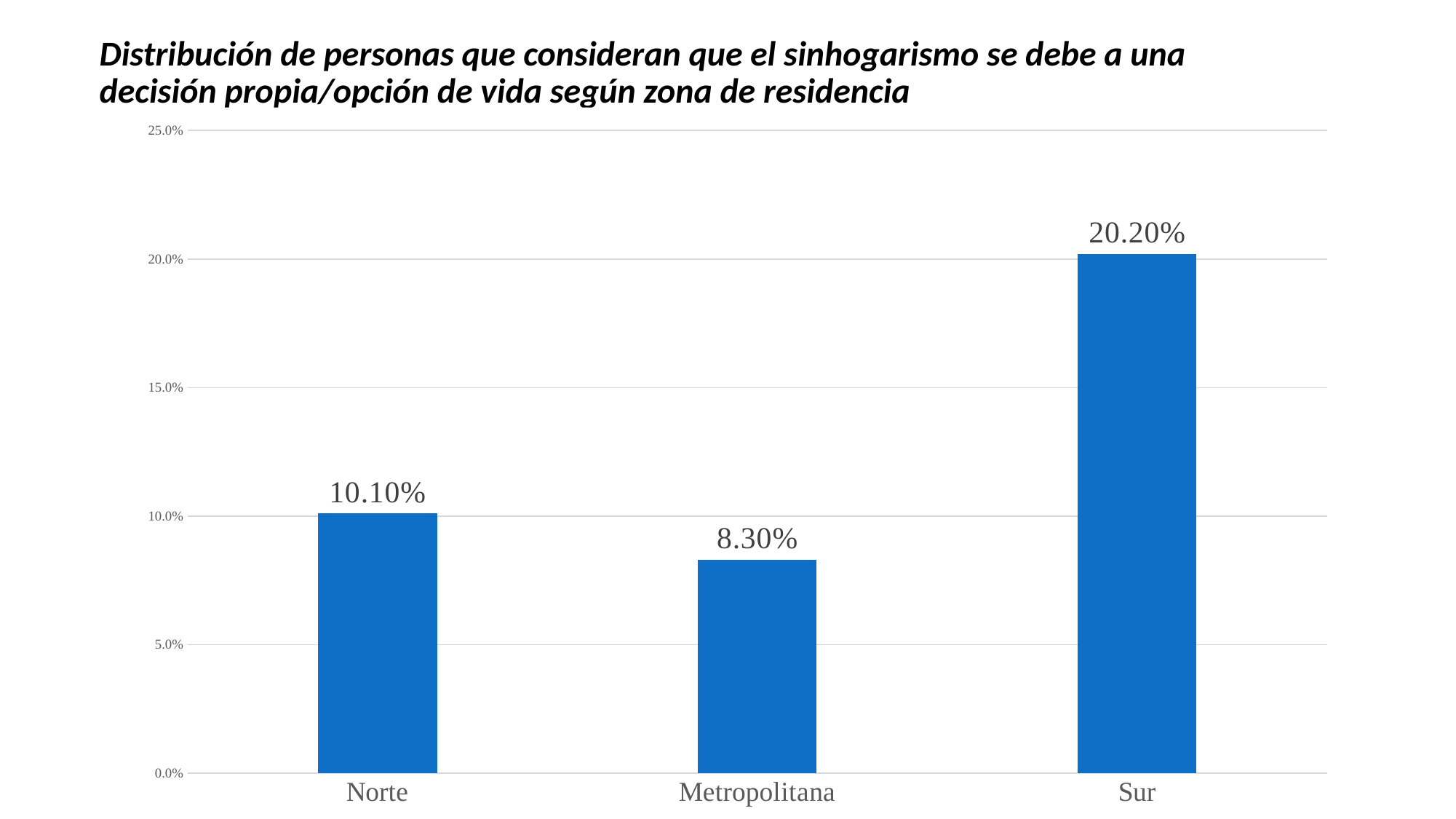
What is the value for Norte? 10.10% Which is larger, the value for Norte or the value for Metropolitana? Norte How many zones are shown on the x axis? 3 What is the difference between the values for Sur and Norte? 10.10% What is the value for Metropolitana? 8.30% Which zone has the highest value? Sur What is the highest value shown on the y axis? 25.0% Is the value for Sur greater or less than 15.0%? greater What kind of chart is shown on the slide? Bar chart What is the difference between the values for Norte and Metropolitana? 1.80% Which zone has the lowest value? Metropolitana What is the value for Sur? 20.20%